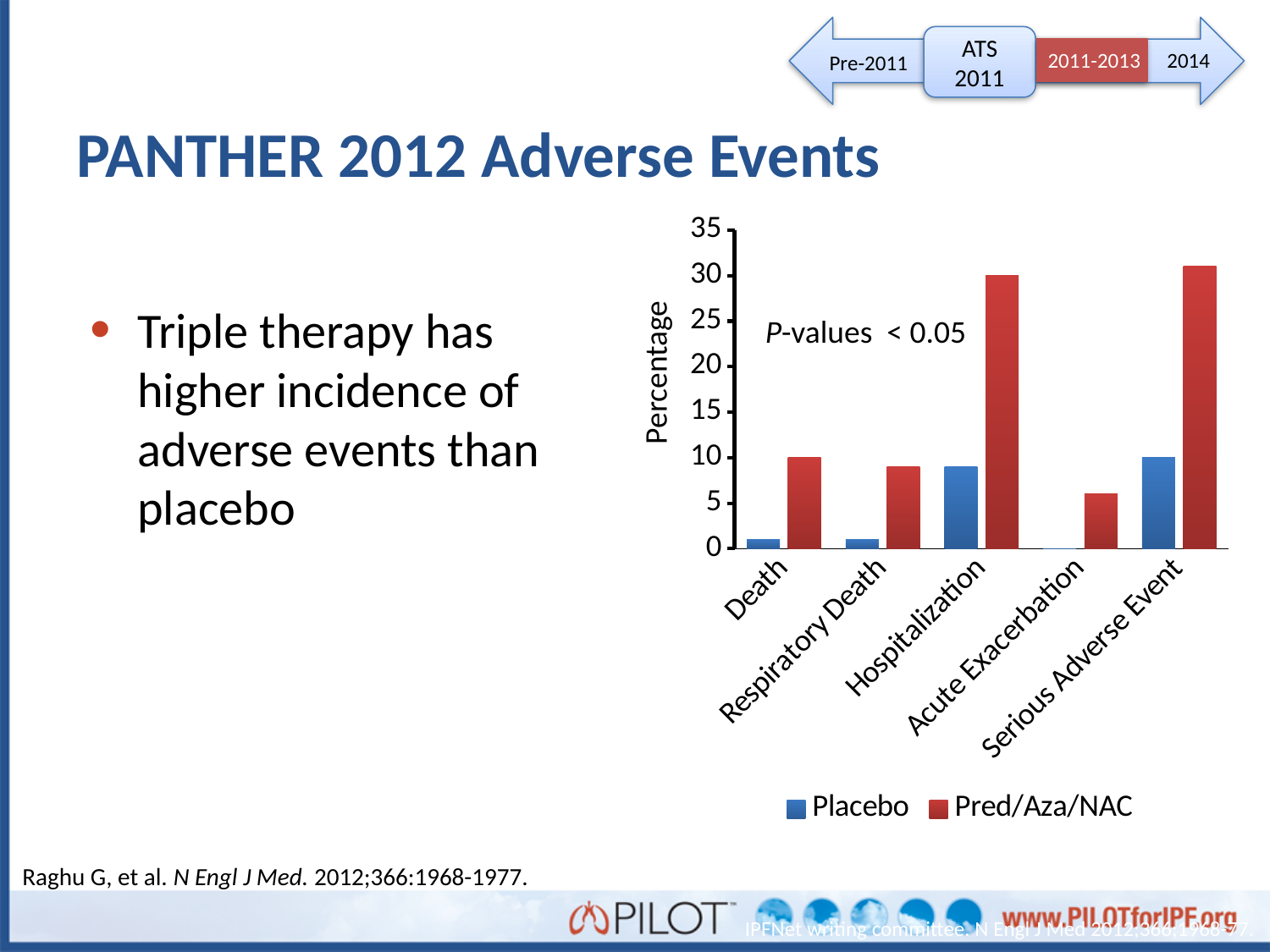
For Hospitalization, which series has the larger value, Placebo or Pred/Aza/NAC? Pred/Aza/NAC Is the Pred/Aza/NAC value for Serious Adverse Event greater or less than 25? greater What is the Pred/Aza/NAC value for Hospitalization? 30 What is the label on the y axis of the chart? Percentage What type of chart is shown on the slide? Bar chart What are the two series named in the chart legend? Placebo and Pred/Aza/NAC What is the Pred/Aza/NAC value for Death? 10 How many adverse event categories are shown on the x axis of the chart? 5 Is the Placebo value for Hospitalization greater or less than 10? less Which category has the lowest Pred/Aza/NAC value? Acute Exacerbation How many series does the chart legend list? 2 Which category has the lowest Placebo value? Acute Exacerbation